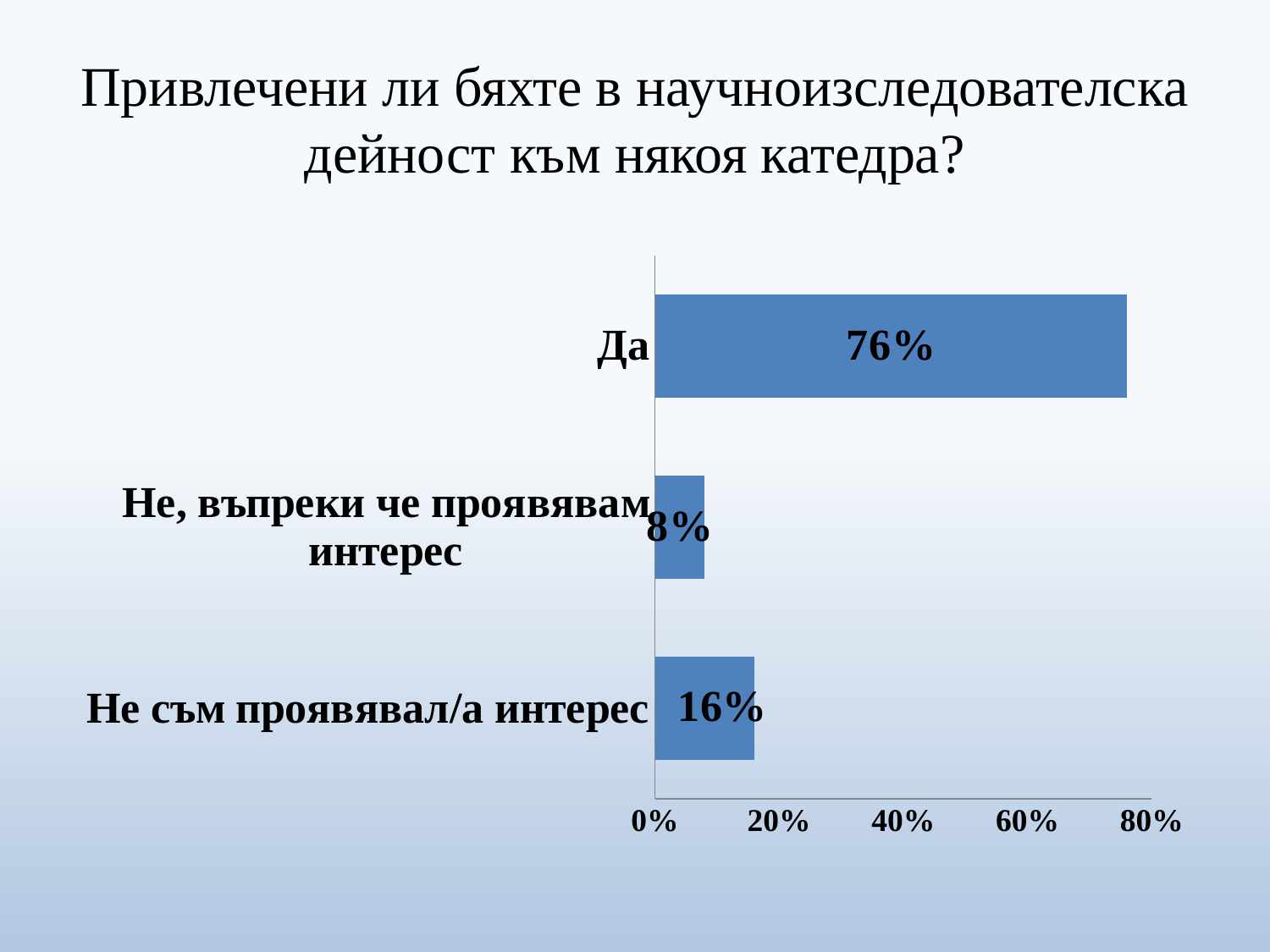
Which category has the highest value? Да What is the value for "Не, въпреки че проявявам интерес"? 8% Which category has the lowest value? Не, въпреки че проявявам интерес What is the difference between the values for "Да" and "Не съм проявявал/а интерес"? 60% How many categories are shown in the chart? 3 What is the difference between the values for "Не съм проявявал/а интерес" and "Не, въпреки че проявявам интерес"? 8% What is the title of the slide? Привлечени ли бяхте в научноизследователска дейност към някоя катедра? Is the value for "Да" greater or less than 60%? greater What is the value for "Не съм проявявал/а интерес"? 16% What is the value for "Да"? 76% Which is larger, the value for "Не съм проявявал/а интерес" or the value for "Не, въпреки че проявявам интерес"? Не съм проявявал/а интерес What kind of chart is shown on the slide? bar chart